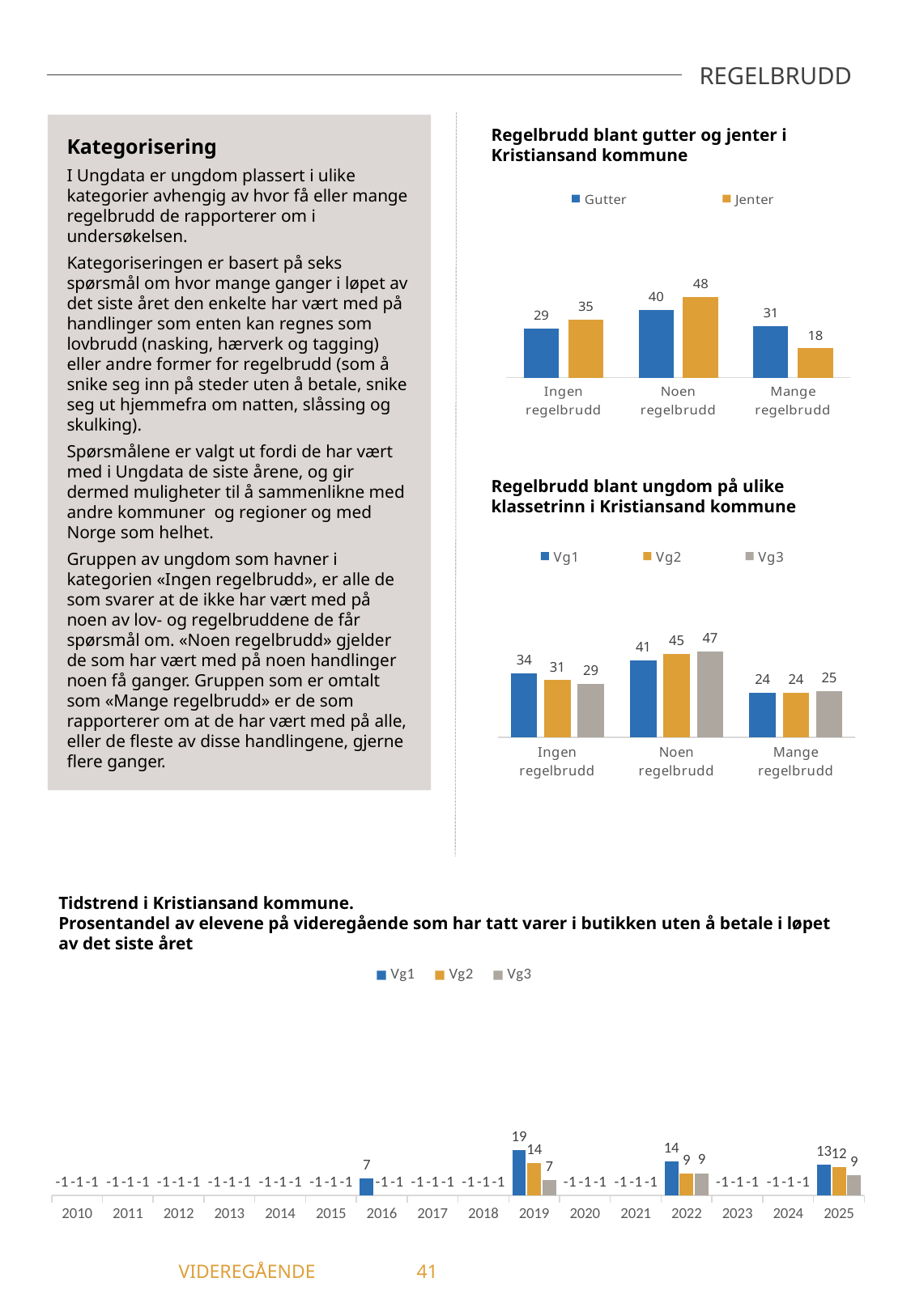
In the chart 'Regelbrudd blant ungdom på ulike klassetrinn i Kristiansand kommune', how many categories are shown on the x axis? 3 In the chart 'Regelbrudd blant ungdom på ulike klassetrinn i Kristiansand kommune', which series has the highest value in the 'Ingen regelbrudd' category? Vg1 In the chart 'Regelbrudd blant gutter og jenter i Kristiansand kommune', how many series does the legend list? 2 In the chart 'Regelbrudd blant ungdom på ulike klassetrinn i Kristiansand kommune', what is the value for Vg3 in the 'Noen regelbrudd' category? 47 In the chart 'Regelbrudd blant ungdom på ulike klassetrinn i Kristiansand kommune', is the value for Vg1 or Vg2 larger in the 'Noen regelbrudd' category? Vg2 In the chart 'Regelbrudd blant gutter og jenter i Kristiansand kommune', what is the difference between Gutter and Jenter in the 'Mange regelbrudd' category? 13 What kind of chart is 'Tidstrend i Kristiansand kommune'? Bar chart In the chart 'Regelbrudd blant gutter og jenter i Kristiansand kommune', what is the value for Jenter in the 'Noen regelbrudd' category? 48 In the chart 'Regelbrudd blant gutter og jenter i Kristiansand kommune', which category has the lowest value for Jenter? Mange regelbrudd In the chart 'Tidstrend i Kristiansand kommune', what is the difference between Vg1 and Vg3 in 2022? 5 In the chart 'Regelbrudd blant gutter og jenter i Kristiansand kommune', what is the value for Gutter in the 'Mange regelbrudd' category? 31 In the chart 'Tidstrend i Kristiansand kommune', what is the value for Vg1 in 2019? 19